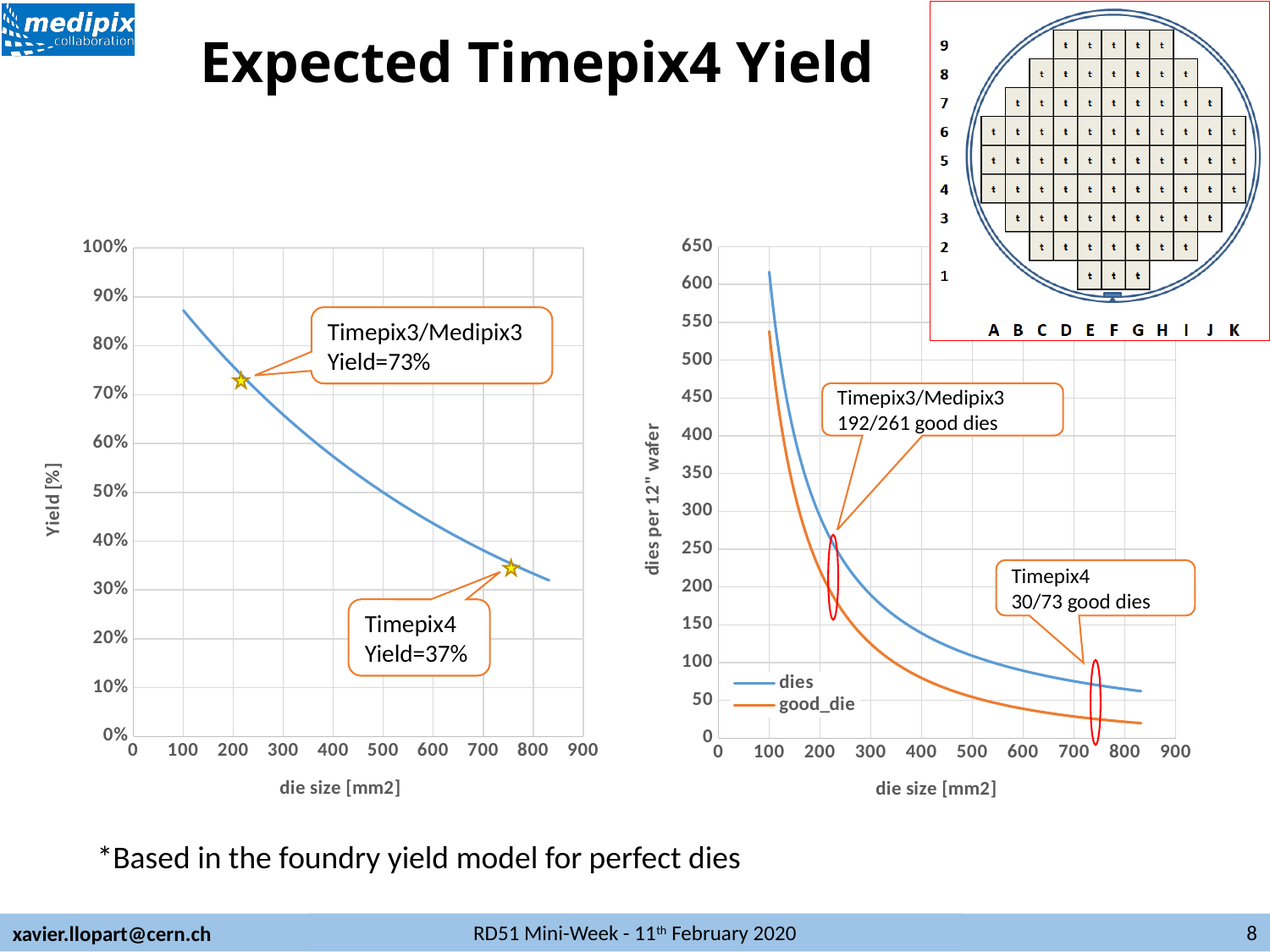
On the left chart (Yield [%] vs die size), what yield is annotated for Timepix4? 37% On the right chart (dies per 12" wafer vs die size), how many series does the legend list? 2 What kind of chart is the left chart (Yield [%] vs die size)? line chart On the left chart (Yield [%] vs die size), which has the higher annotated yield, Timepix3/Medipix3 or Timepix4? Timepix3/Medipix3 On the left chart (Yield [%] vs die size), is the yield at a die size of 800 mm2 greater or less than 40%? less On the left chart (Yield [%] vs die size), what yield is annotated for Timepix3/Medipix3? 73% On the right chart (dies per 12" wafer vs die size), is the value of the dies series at a die size of 100 mm2 greater or less than 600? greater On the right chart (dies per 12" wafer vs die size), how many good dies are annotated for Timepix4? 30/73 good dies On the left chart (Yield [%] vs die size), does the yield rise or fall as die size increases? fall On the right chart (dies per 12" wafer vs die size), how many good dies are annotated for Timepix3/Medipix3? 192/261 good dies On the left chart (Yield [%] vs die size), what is the difference between the annotated Timepix3/Medipix3 yield and the Timepix4 yield? 36% On the right chart (dies per 12" wafer vs die size), which series lies higher across the plotted range, dies or good_die? dies